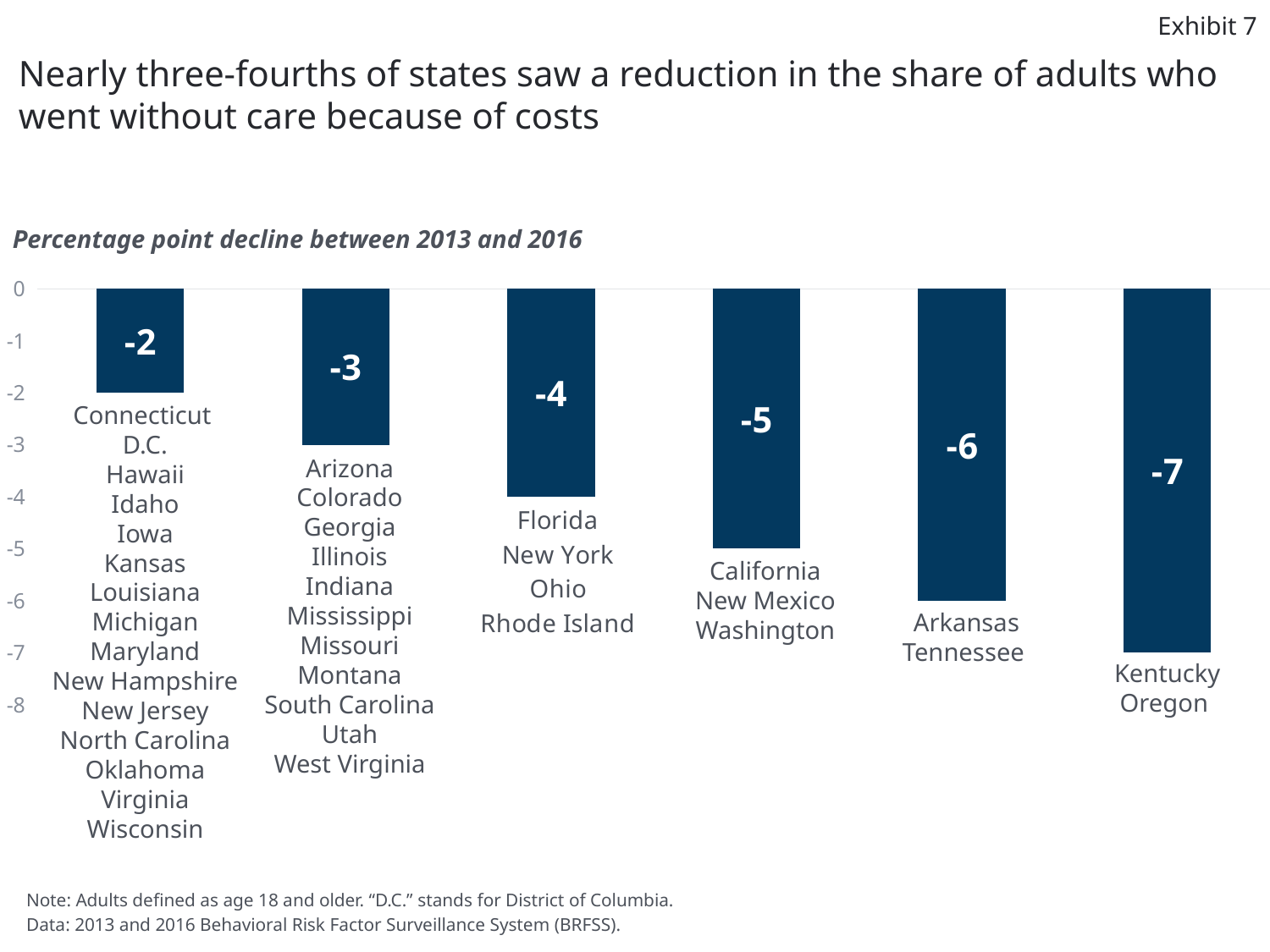
What kind of chart is shown on the slide? Bar chart What is the percentage point decline shown for the bar that includes Florida, New York, Ohio and Rhode Island? -4 Which bar shows the smallest decline, and what is its value? The Connecticut/D.C./Hawaii group, -2 What value is labeled on the bar for Kentucky and Oregon? -7 What does the italic label above the chart say the values represent? Percentage point decline between 2013 and 2016 Which group of states has the largest percentage point decline (the longest bar)? Kentucky and Oregon What value is labeled on the bar that includes California, New Mexico and Washington? -5 Do the bar values become more negative or less negative moving from left to right across the chart? More negative What is the difference between the value for the Kentucky/Oregon bar and the value for the Arizona/Colorado group bar? 4 How many bars are plotted in the chart? 6 Which bar shows a larger decline: the one for Arkansas and Tennessee or the one for Florida, New York, Ohio and Rhode Island? Arkansas and Tennessee What value is labeled on the bar for Arkansas and Tennessee? -6